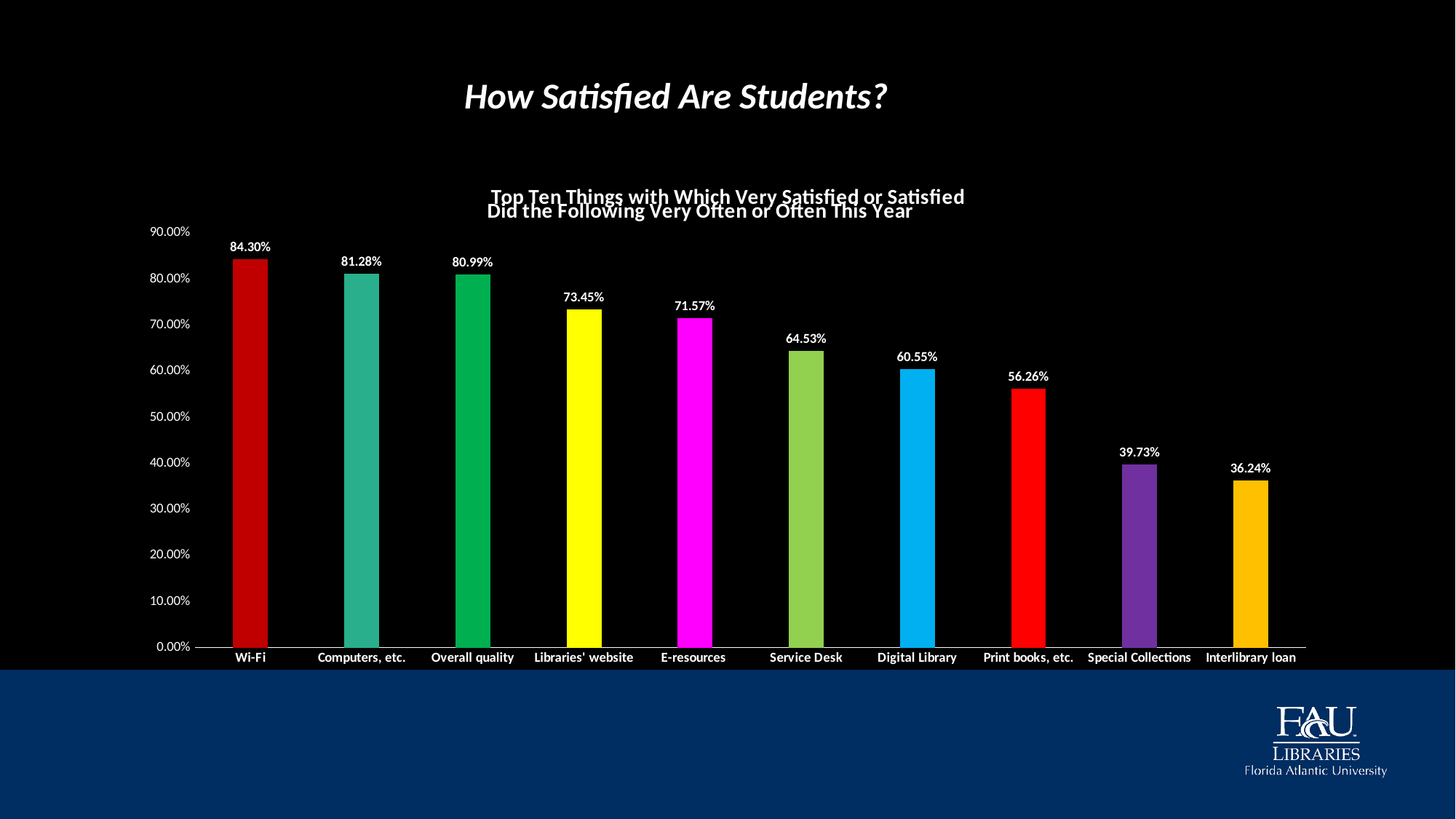
Is the value for Special Collections greater or less than 40.00%? less What is the difference between the values for Wi-Fi and Interlibrary loan? 48.06% What is the value shown for Interlibrary loan? 36.24% What is the satisfaction value for Wi-Fi? 84.30% What is the difference between the values for Libraries' website and E-resources? 1.88% Which is larger, the value for Digital Library or the value for Print books, etc.? Digital Library Do the values rise or fall from left to right along the x axis? fall Which category has the highest value? Wi-Fi What kind of chart is shown on the slide? bar chart Which category has the lowest value? Interlibrary loan What is the value shown for Service Desk? 64.53% How many categories are shown on the x axis? 10